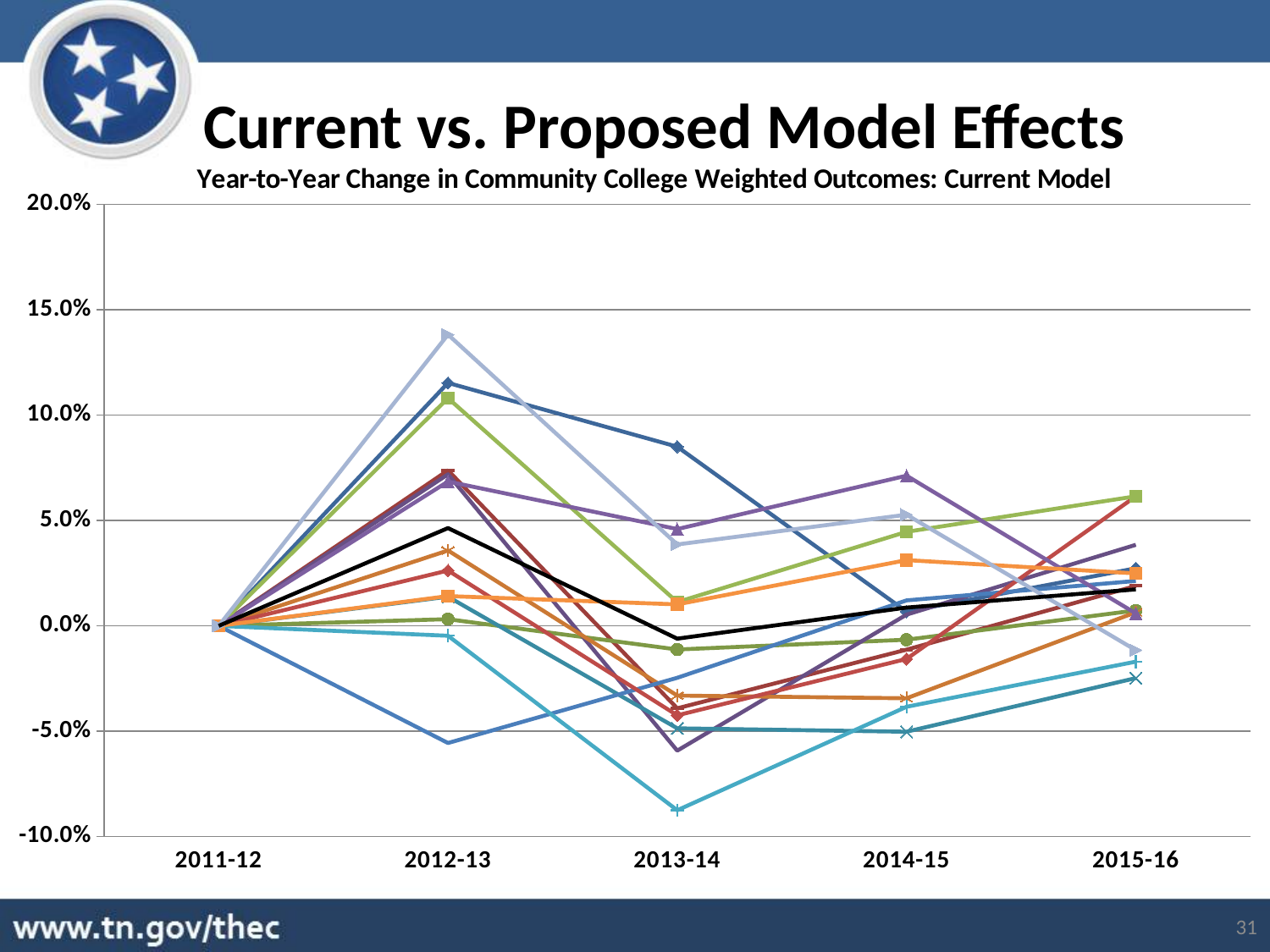
In which year does the lowest point of any line occur? 2013-14 In which year does the highest point of any line occur? 2012-13 What kind of chart is shown on the slide? Line chart What is the lowest value shown on the y axis? -10.0% What is the title of the chart? Year-to-Year Change in Community College Weighted Outcomes: Current Model Is the highest point in 2012-13 greater or less than 10.0%? greater What is the first academic year shown on the x axis? 2011-12 Is the lowest point in 2013-14 greater or less than -5.0%? less What is the highest value shown on the y axis? 20.0% Is the highest point in 2015-16 greater or less than 10.0%? less What value do all the lines share at 2011-12? 0.0% How many academic years are shown on the x axis of the chart? 5